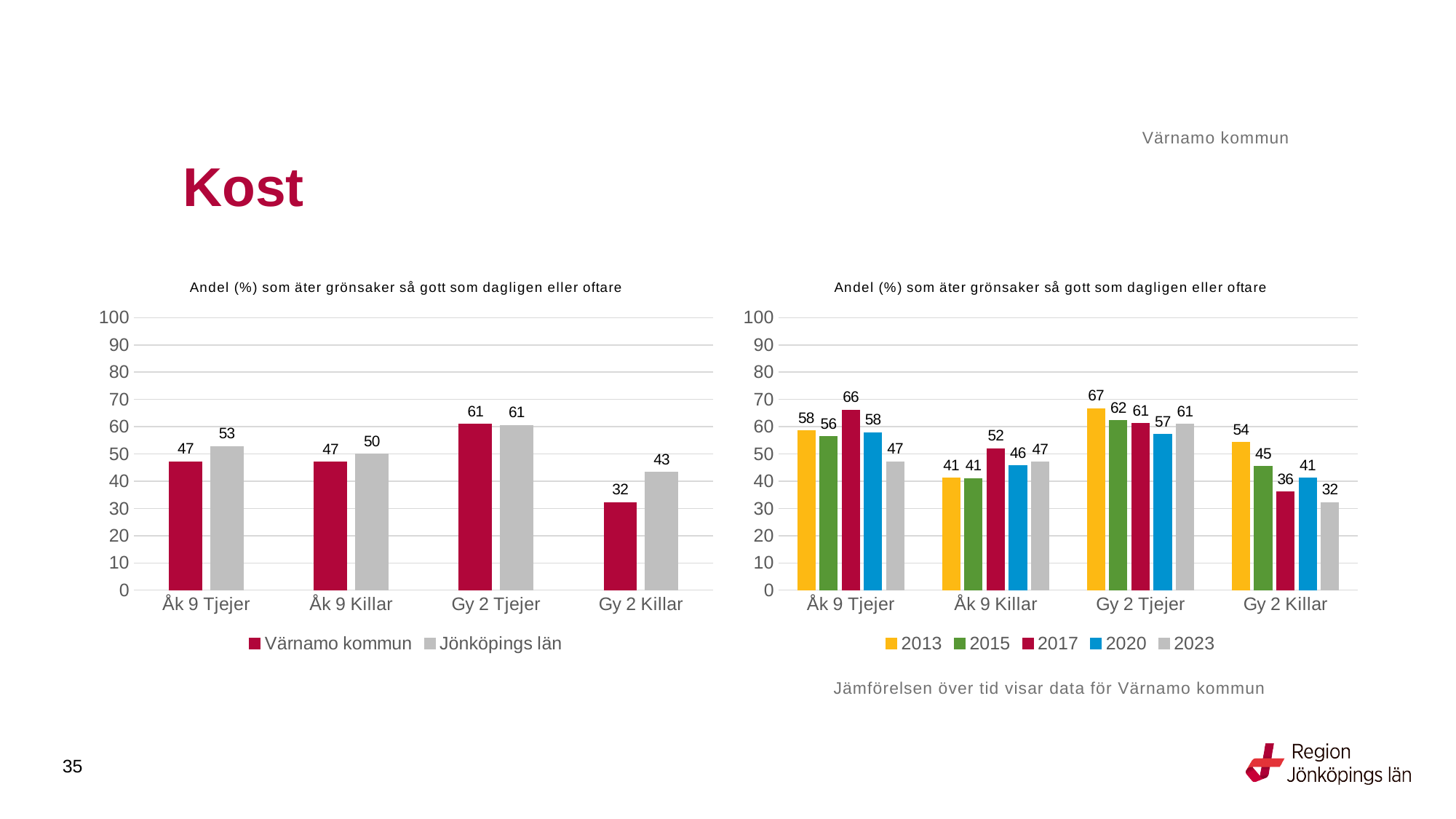
In the right chart, how many series does the legend list? 5 In the left chart, what is the difference between Jönköpings län and Värnamo kommun for Gy 2 Killar? 11 In the right chart, what is the value for 2017 for Åk 9 Tjejer? 66 In the left chart, which category has the lowest value for Värnamo kommun? Gy 2 Killar In the right chart, which year has the highest value for Gy 2 Tjejer? 2013 In the left chart, how many series does the legend list? 2 In the left chart, what is the value for Jönköpings län for Åk 9 Tjejer? 53 In the right chart, how many categories are shown on the x axis? 4 In the right chart, what is the value for 2023 for Gy 2 Killar? 32 What kind of chart is the left chart? bar chart In the right chart, is the value for 2013 for Gy 2 Killar larger or smaller than the value for 2015 for Gy 2 Killar? larger In the left chart, what is the value for Värnamo kommun for Gy 2 Killar? 32